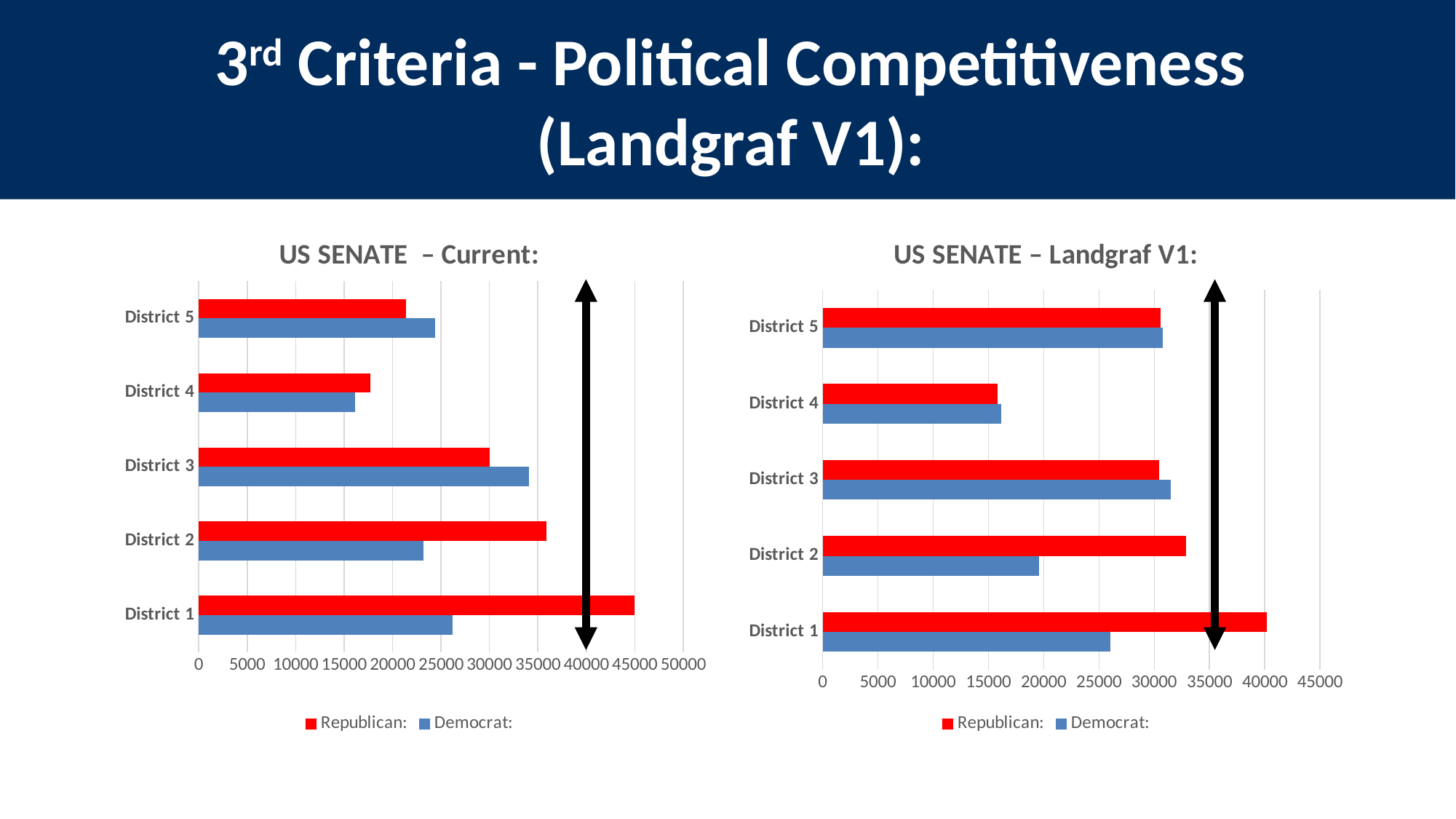
In the 'US SENATE – Current:' chart, is the Republican value for District 2 greater or less than 30000? greater In the 'US SENATE – Landgraf V1:' chart, which district has the highest Republican value? District 1 In the 'US SENATE – Landgraf V1:' chart, for District 2, which is larger: the Republican or the Democrat value? Republican In the 'US SENATE – Current:' chart, is the Democrat value for District 5 greater or less than 20000? greater In the 'US SENATE – Landgraf V1:' chart, is the Democrat value for District 2 greater or less than 25000? less How many series does the legend of the 'US SENATE – Current:' chart list? 2 In the 'US SENATE – Current:' chart, which district has the highest Republican value? District 1 In the 'US SENATE – Landgraf V1:' chart, which district has the lowest Republican value? District 4 In the 'US SENATE – Current:' chart, for District 3, which is larger: the Republican or the Democrat value? Democrat How many districts are shown on the 'US SENATE – Landgraf V1:' chart? 5 What kind of chart is the 'US SENATE – Current:' chart? bar chart In the 'US SENATE – Current:' chart, which district has the lowest Democrat value? District 4